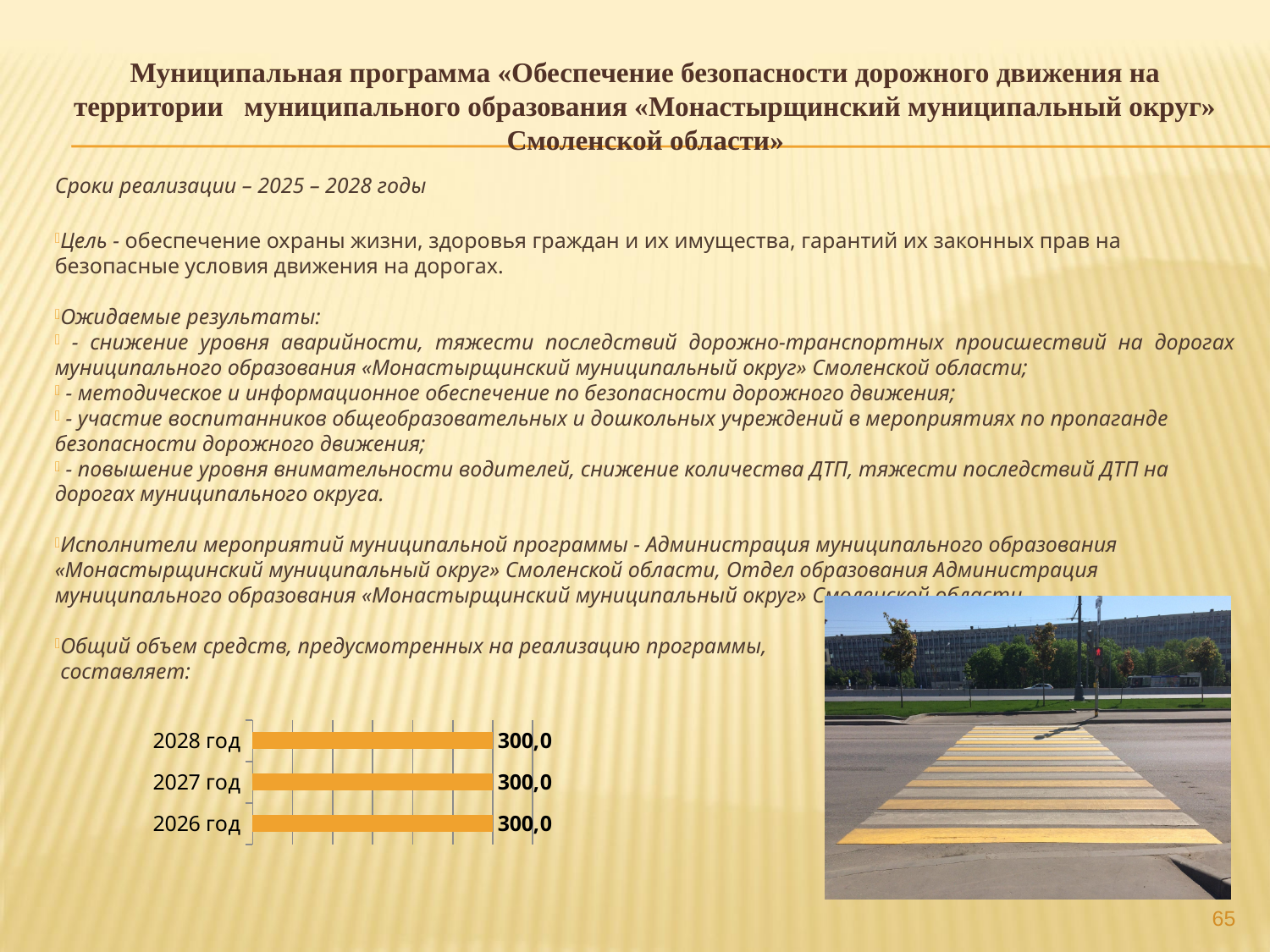
How many categories (years) are shown in the bar chart? 3 What colour are the bars in the chart? Orange What is the value for 2026 год in the bar chart? 300,0 What is the difference between the values for 2028 год and 2026 год in the bar chart? 0,0 Do the values in the bar chart rise, fall, or stay the same from 2026 год to 2028 год? Stay the same Which year is listed at the top of the bar chart? 2028 год What kind of chart is shown on the slide? Bar chart Are the bars in the chart horizontal or vertical? Horizontal What is the value for 2028 год in the bar chart? 300,0 What is the value for 2027 год in the bar chart? 300,0